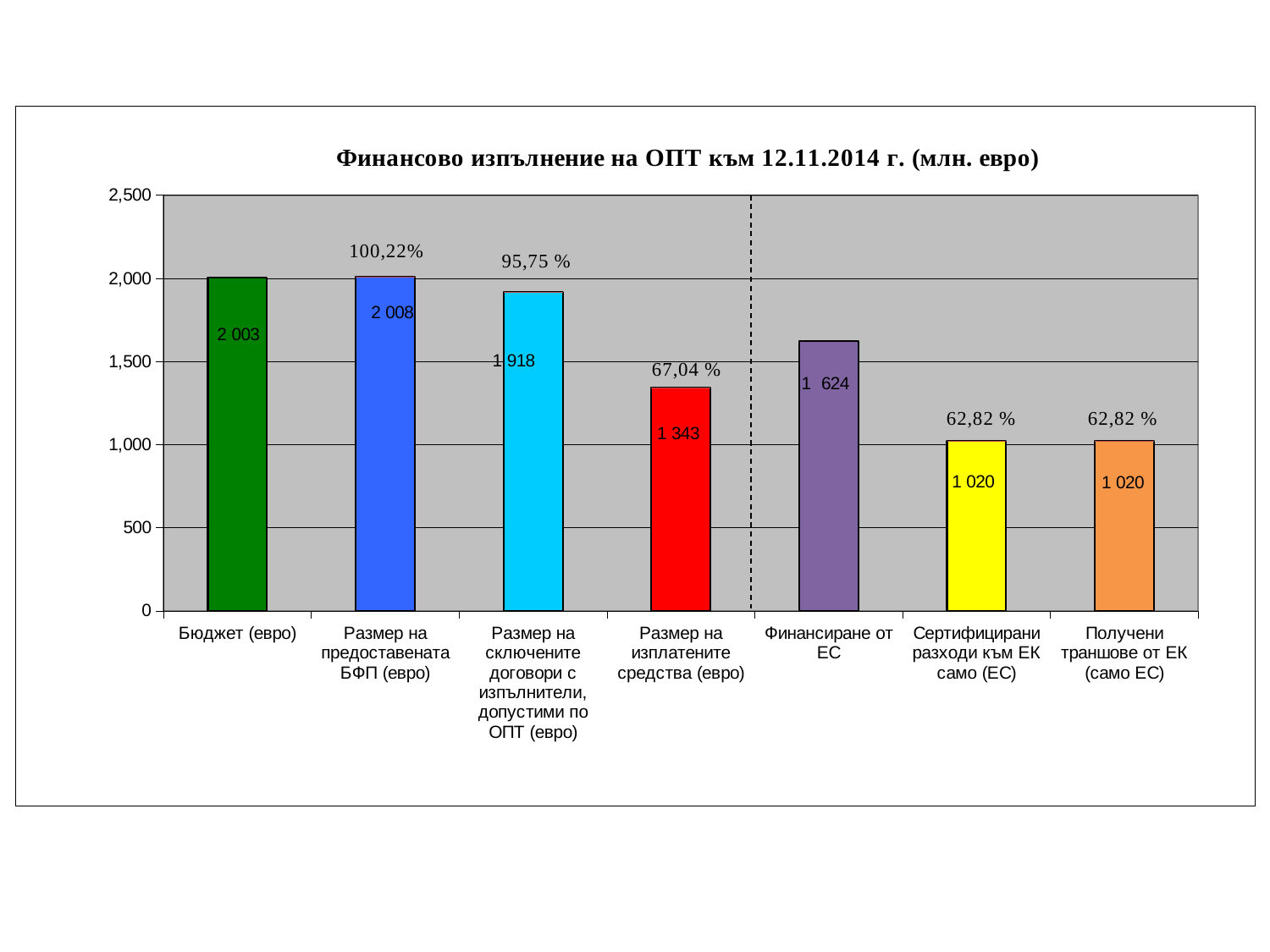
How many categories are shown in the chart? 7 Which category has the highest value? Размер на предоставената БФП (евро) What is the value for Финансиране от ЕС? 1 624 What is the value for Размер на изплатените средства (евро)? 1 343 What kind of chart is shown on the slide? bar chart What is the difference between Финансиране от ЕС and Сертифицирани разходи към ЕК само (ЕС)? 604 What percentage is shown above the bar for Получени траншове от ЕК (само ЕС)? 62,82 % Which is larger: Размер на сключените договори с изпълнители, допустими по ОПТ (евро) or Финансиране от ЕС? Размер на сключените договори с изпълнители, допустими по ОПТ (евро) Is the value for Финансиране от ЕС greater or less than 1,500? greater What is the value for Бюджет (евро)? 2 003 What is the difference between Бюджет (евро) and Размер на изплатените средства (евро)? 660 What percentage is shown above the bar for Размер на сключените договори с изпълнители, допустими по ОПТ (евро)? 95,75 %